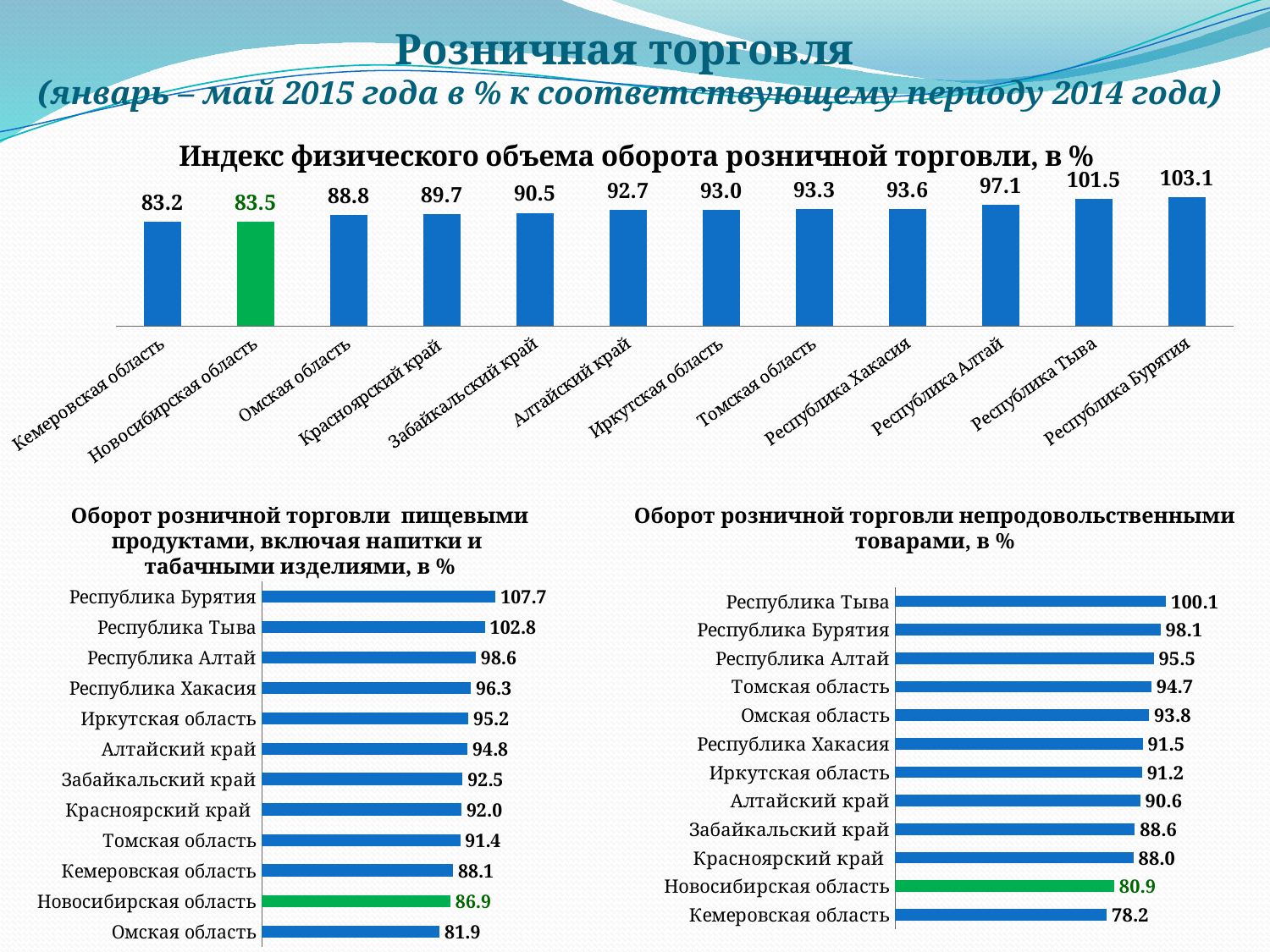
In the top chart 'Индекс физического объема оборота розничной торговли, в %', which bar is coloured green? Новосибирская область In the bottom-right chart on non-food goods, what is the value for Томская область? 94.7 In the top chart 'Индекс физического объема оборота розничной торговли, в %', what is the value for Красноярский край? 89.7 In the bottom-right chart on non-food goods, which is larger: Республика Хакасия or Алтайский край? Республика Хакасия In the bottom-left chart on food products, what is the difference between Республика Бурятия and Омская область? 25.8 In the top chart 'Индекс физического объема оборота розничной торговли, в %', how many regions are shown? 12 What type of chart is the bottom-right chart on non-food goods? bar chart In the bottom-left chart on food products, what is the value for Иркутская область? 95.2 In the top chart 'Индекс физического объема оборота розничной торговли, в %', which region has the lowest value? Кемеровская область In the bottom-left chart on food products, which region has the lowest value? Омская область In the top chart 'Индекс физического объема оборота розничной торговли, в %', what is the difference between Республика Тыва and Новосибирская область? 18.0 In the top chart 'Индекс физического объема оборота розничной торговли, в %', which region has the highest value? Республика Бурятия